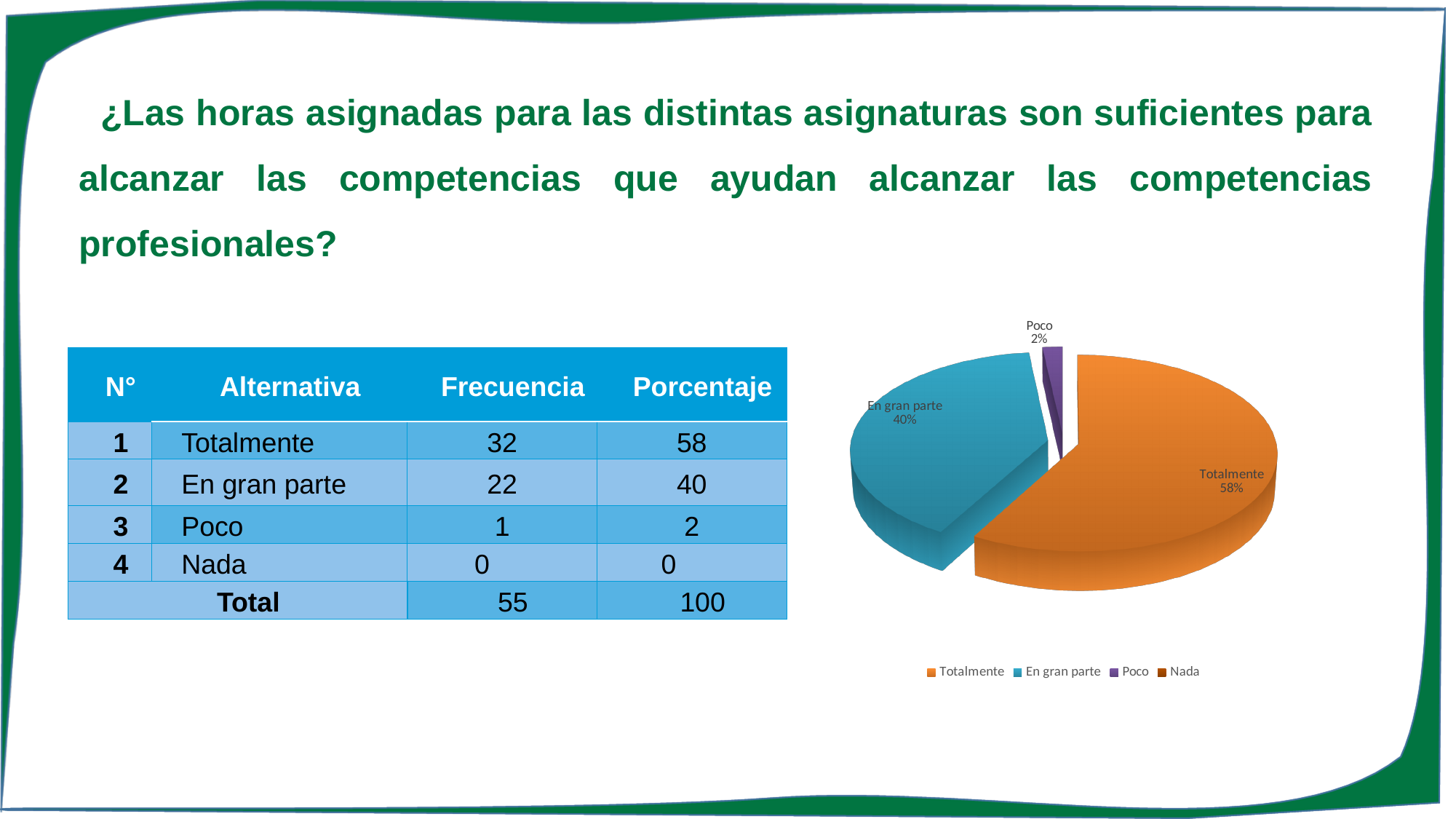
What share of the pie does En gran parte have? 40% What kind of chart is shown on the slide? pie chart Which legend entry does not appear as a visible slice in the pie? Nada What colour is the Totalmente slice? orange Which labelled slice of the pie is the smallest? Poco How many entries does the legend list? 4 What share of the pie does Poco have? 2% What is the combined share of Totalmente and En gran parte? 98% What share of the pie does Totalmente have? 58% What is the difference in percentage points between Totalmente and En gran parte? 18 Which category has the largest slice of the pie? Totalmente Which is larger, the slice for En gran parte or the slice for Poco? En gran parte